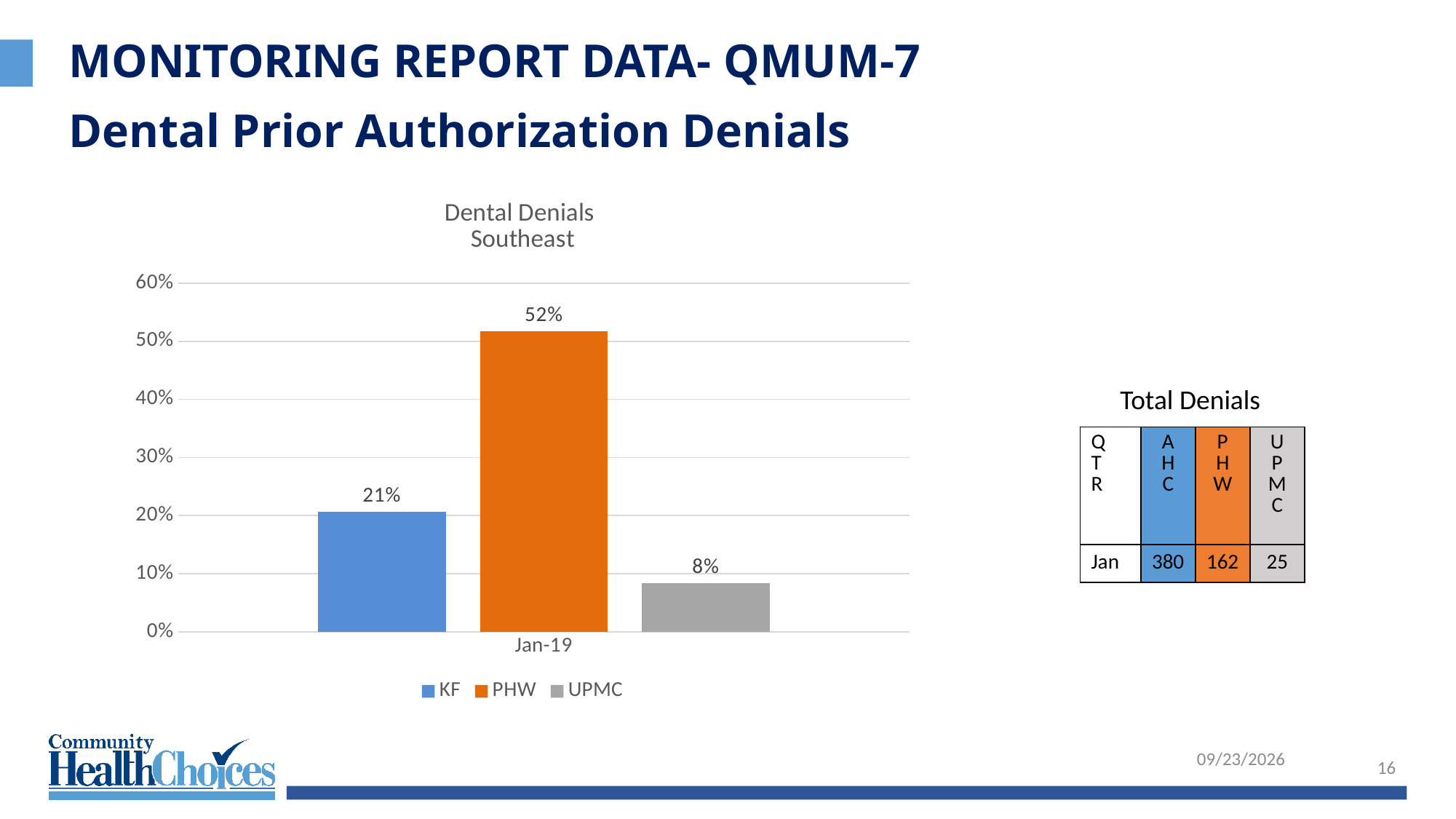
Which series has the highest value in the Dental Denials Southeast chart? PHW What colour is the PHW bar in the Dental Denials Southeast chart? orange What is the difference between the PHW and KF values in the Dental Denials Southeast chart? 31% What is the value for KF in the Dental Denials Southeast chart? 21% What is the value for UPMC in the Dental Denials Southeast chart? 8% Which is larger in the Dental Denials Southeast chart, KF or UPMC? KF Is the value for PHW in the Dental Denials Southeast chart greater or less than 50%? greater Which series has the lowest value in the Dental Denials Southeast chart? UPMC What period is shown on the x axis of the Dental Denials Southeast chart? Jan-19 What kind of chart is the Dental Denials Southeast chart? bar chart What is the value for PHW in the Dental Denials Southeast chart? 52% How many series does the legend of the Dental Denials Southeast chart list? 3